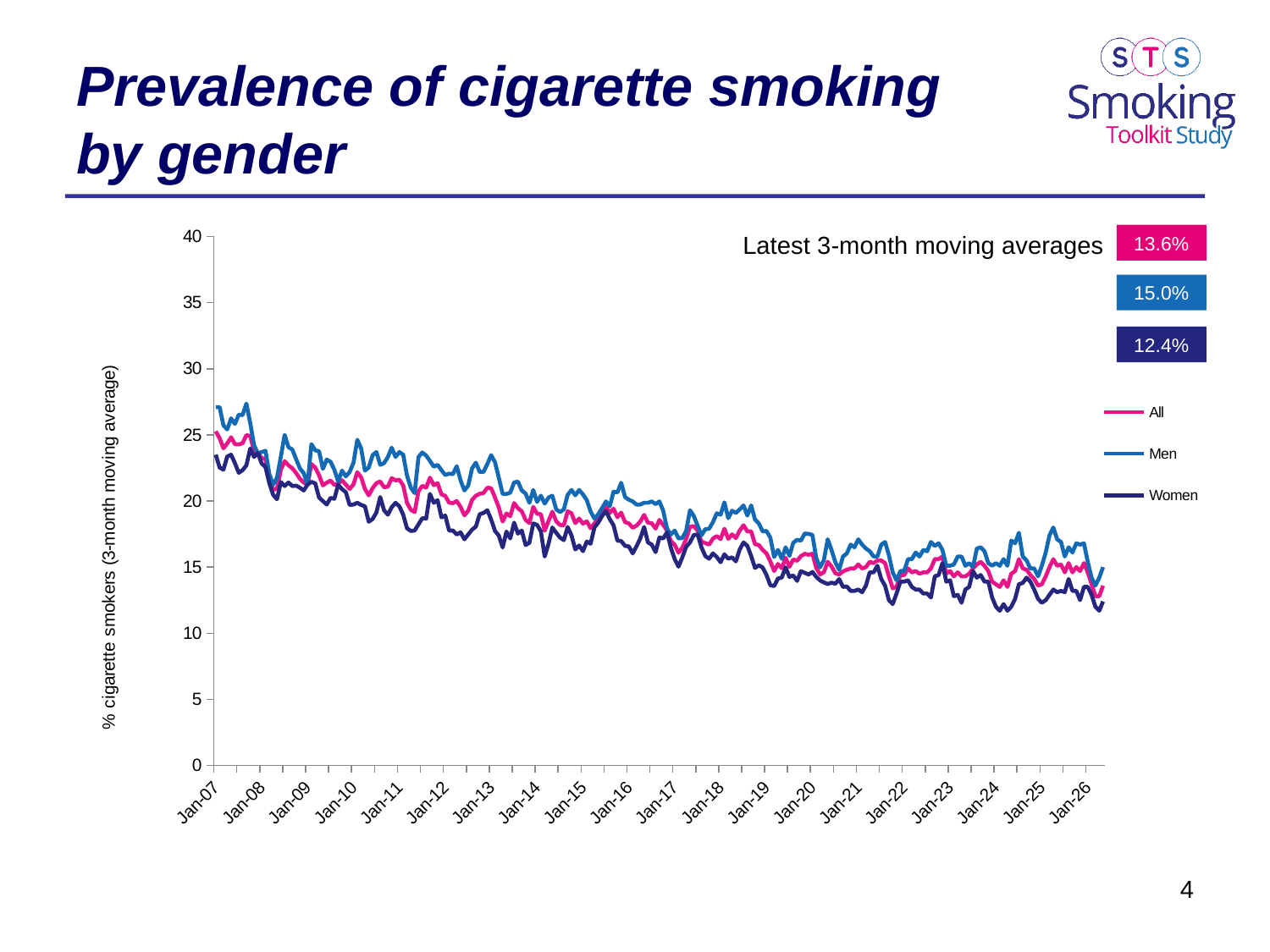
Is the latest 3-month moving average higher for Men or for All? Men What kind of chart is shown on the slide? Line chart How many series does the legend list? 3 Which group has the highest latest 3-month moving average? Men What is the difference between the latest 3-month moving averages for Men and Women? 2.6 percentage points Is the value for Women at Jan-07 greater or less than 25? less Is the value for Men at Jan-07 greater or less than 25? greater What is the latest 3-month moving average for Women? 12.4% What is the latest 3-month moving average for All? 13.6% What is the latest 3-month moving average for Men? 15.0% Which group has the lowest latest 3-month moving average? Women Do the smoking prevalence values rise or fall from Jan-07 to Jan-26? Fall